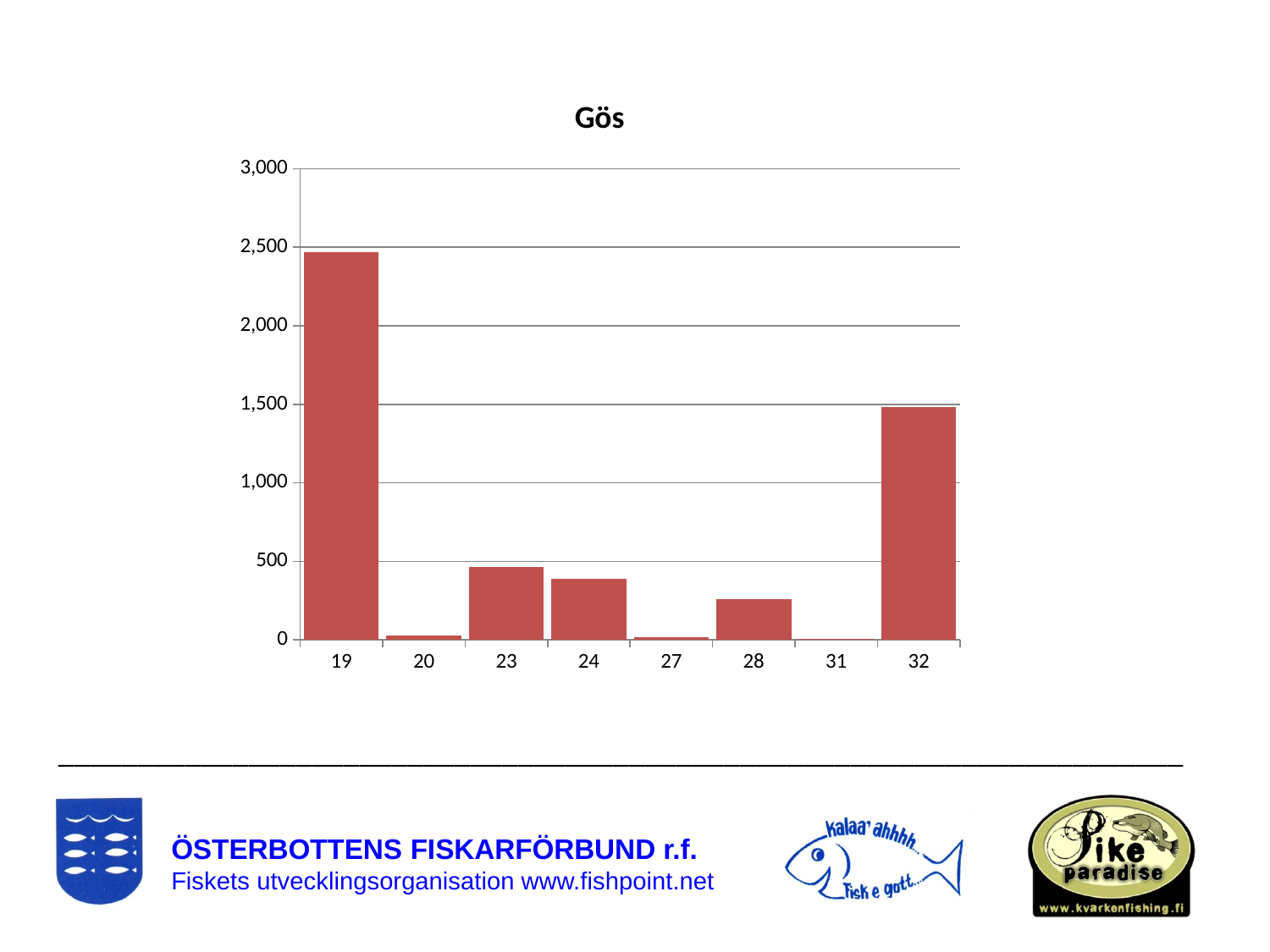
Is the value for category 19 greater or less than 2,000? greater What kind of chart is shown on the slide? bar chart Is the value for category 32 greater or less than 1,000? greater Is the value for category 28 greater or less than 500? less What is the title of the chart? Gös Which category has the highest value in the chart? 19 Which has the larger value, category 24 or category 28? 24 How many categories are shown on the x axis of the chart? 8 Which has the larger value, category 19 or category 32? 19 What is the highest value shown on the y axis of the chart? 3,000 Which has the larger value, category 23 or category 24? 23